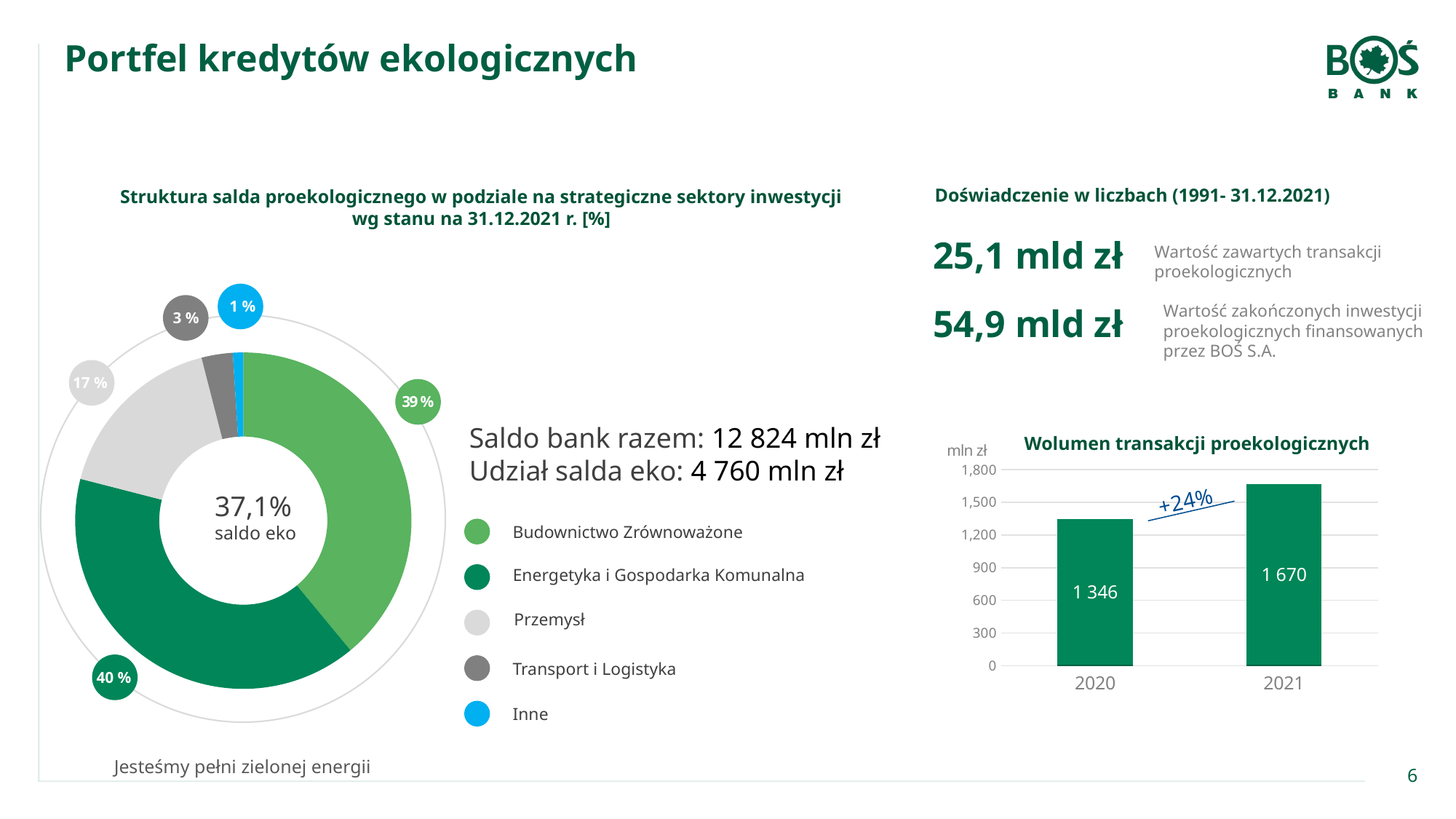
In the donut chart on the left, how many sectors are shown in the legend? 5 In the donut chart on the left, which sector has the smallest share? Inne In the donut chart on the left, what share does Przemysł have? 17 % In the chart 'Wolumen transakcji proekologicznych', do the values rise or fall from 2020 to 2021? Rise What type of chart is 'Wolumen transakcji proekologicznych'? Bar chart In the donut chart on the left, what percentage is shown in the centre of the chart? 37,1% In the donut chart on the left, what share does Budownictwo Zrównoważone have? 39 % In the chart 'Wolumen transakcji proekologicznych', what is the value for 2020? 1 346 In the chart 'Wolumen transakcji proekologicznych', what is the difference between the 2021 and 2020 values? 324 In the chart 'Wolumen transakcji proekologicznych', what is the value for 2021? 1 670 In the donut chart on the left, what is the difference in percentage points between Przemysł and Transport i Logistyka? 14 In the donut chart on the left, which sector has the largest share? Energetyka i Gospodarka Komunalna